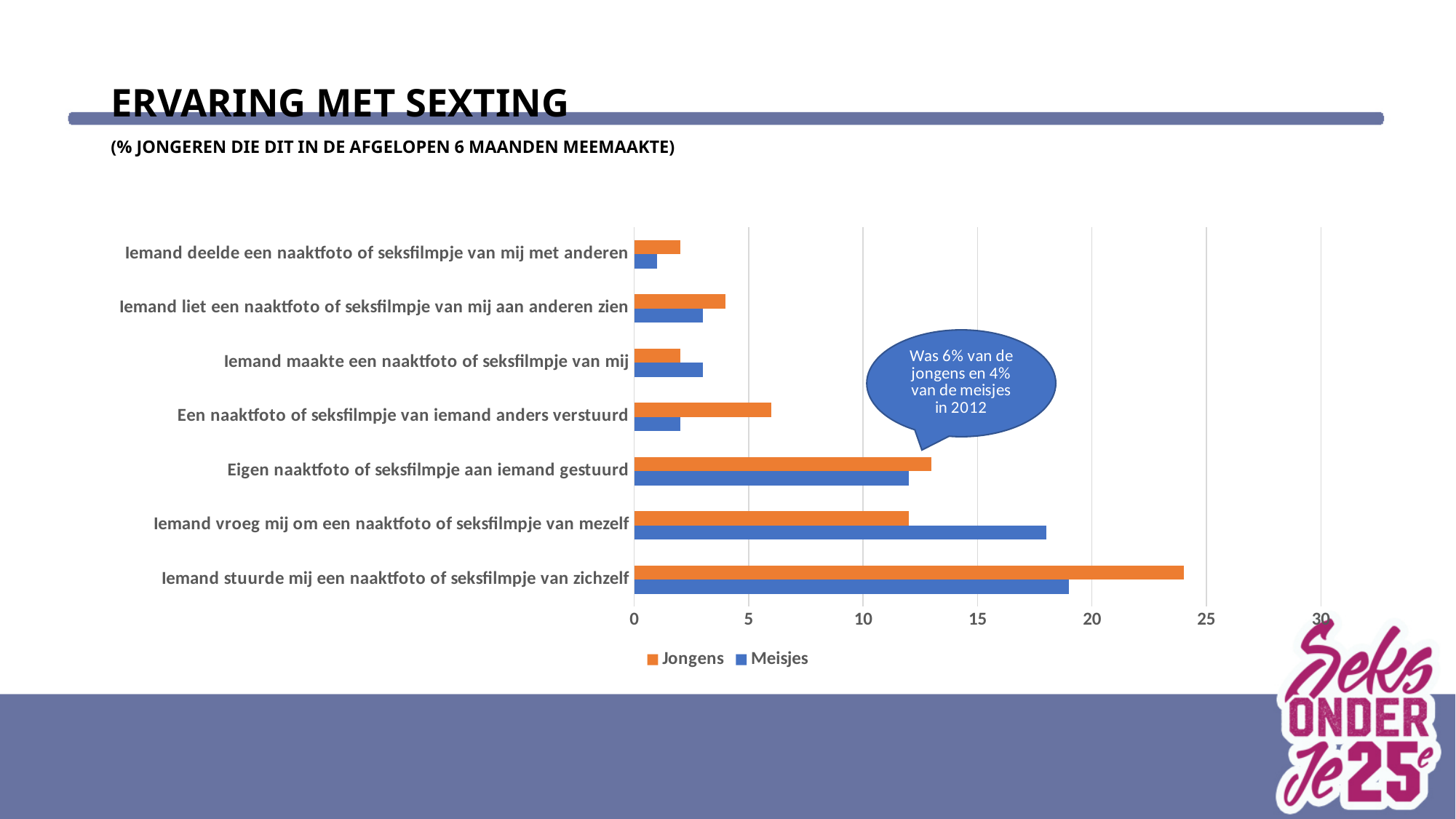
Is the value for Jongens for 'Iemand stuurde mij een naaktfoto of seksfilmpje van zichzelf' greater or less than 20? greater How many categories are shown on the chart? 7 What kind of chart is shown on the slide? bar chart Which category has the highest value for Jongens? Iemand stuurde mij een naaktfoto of seksfilmpje van zichzelf For 'Iemand vroeg mij om een naaktfoto of seksfilmpje van mezelf', which is larger: Jongens or Meisjes? Meisjes How many series does the legend list? 2 Is the value for Jongens for 'Een naaktfoto of seksfilmpje van iemand anders verstuurd' greater or less than 10? less Is the value for Meisjes for 'Iemand vroeg mij om een naaktfoto of seksfilmpje van mezelf' greater or less than 15? greater Which category has the lowest value for Meisjes? Iemand deelde een naaktfoto of seksfilmpje van mij met anderen Which colour represents the Jongens series in the chart? orange For 'Een naaktfoto of seksfilmpje van iemand anders verstuurd', which is larger: Jongens or Meisjes? Jongens Which category has the highest value for Meisjes? Iemand stuurde mij een naaktfoto of seksfilmpje van zichzelf